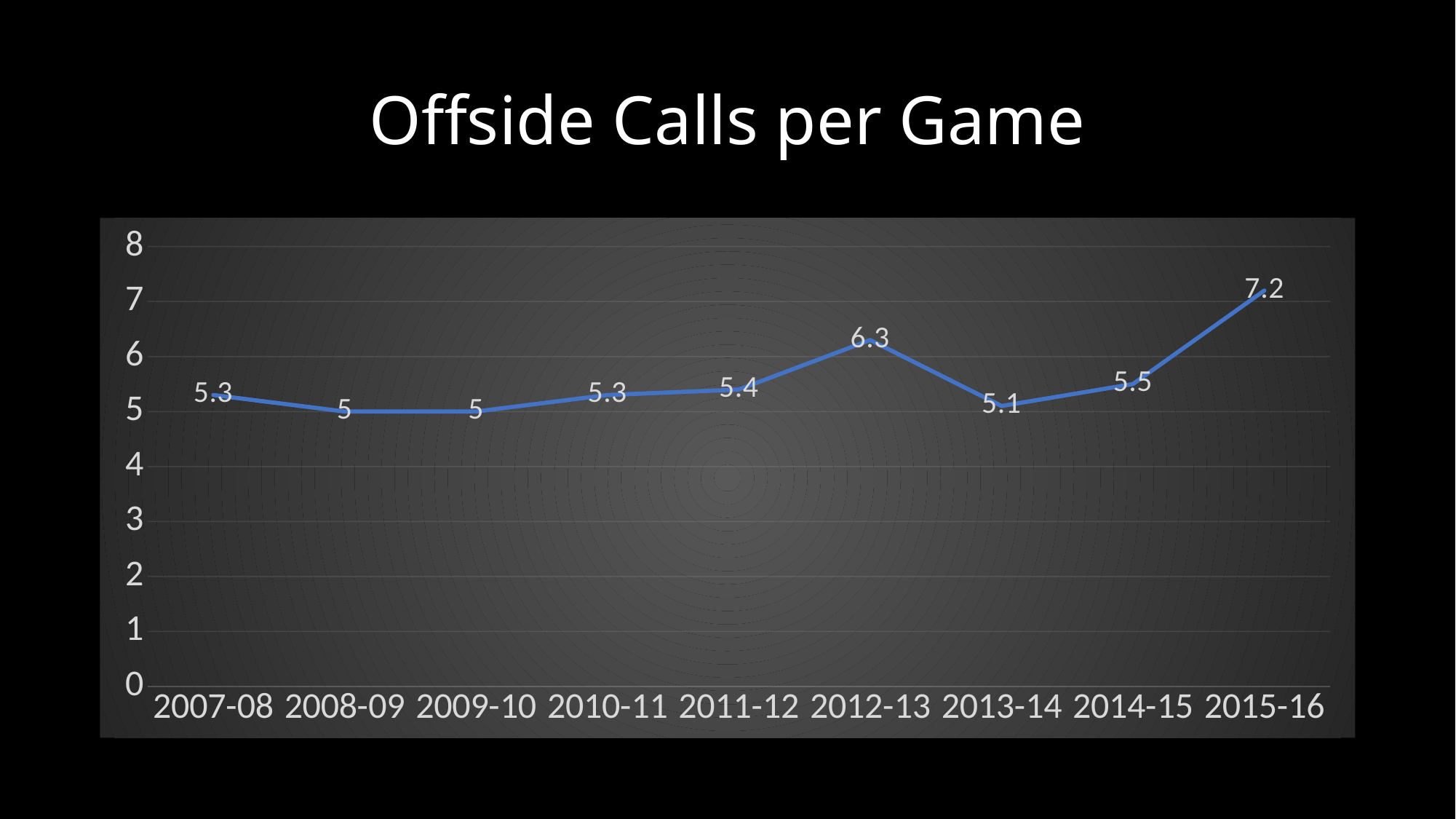
Which season has the highest value? 2015-16 What is the difference between the values for 2015-16 and 2014-15? 1.7 What is the value for 2013-14? 5.1 What kind of chart is shown? line chart What is the difference between the values for 2012-13 and 2013-14? 1.2 What is the value for 2015-16? 7.2 Which is larger, the value for 2011-12 or the value for 2010-11? 2011-12 How many seasons are plotted on the x axis? 9 What is the value for 2008-09? 5 Is the value for 2015-16 greater or less than 7? greater What is the title of the chart? Offside Calls per Game What is the value for 2012-13? 6.3